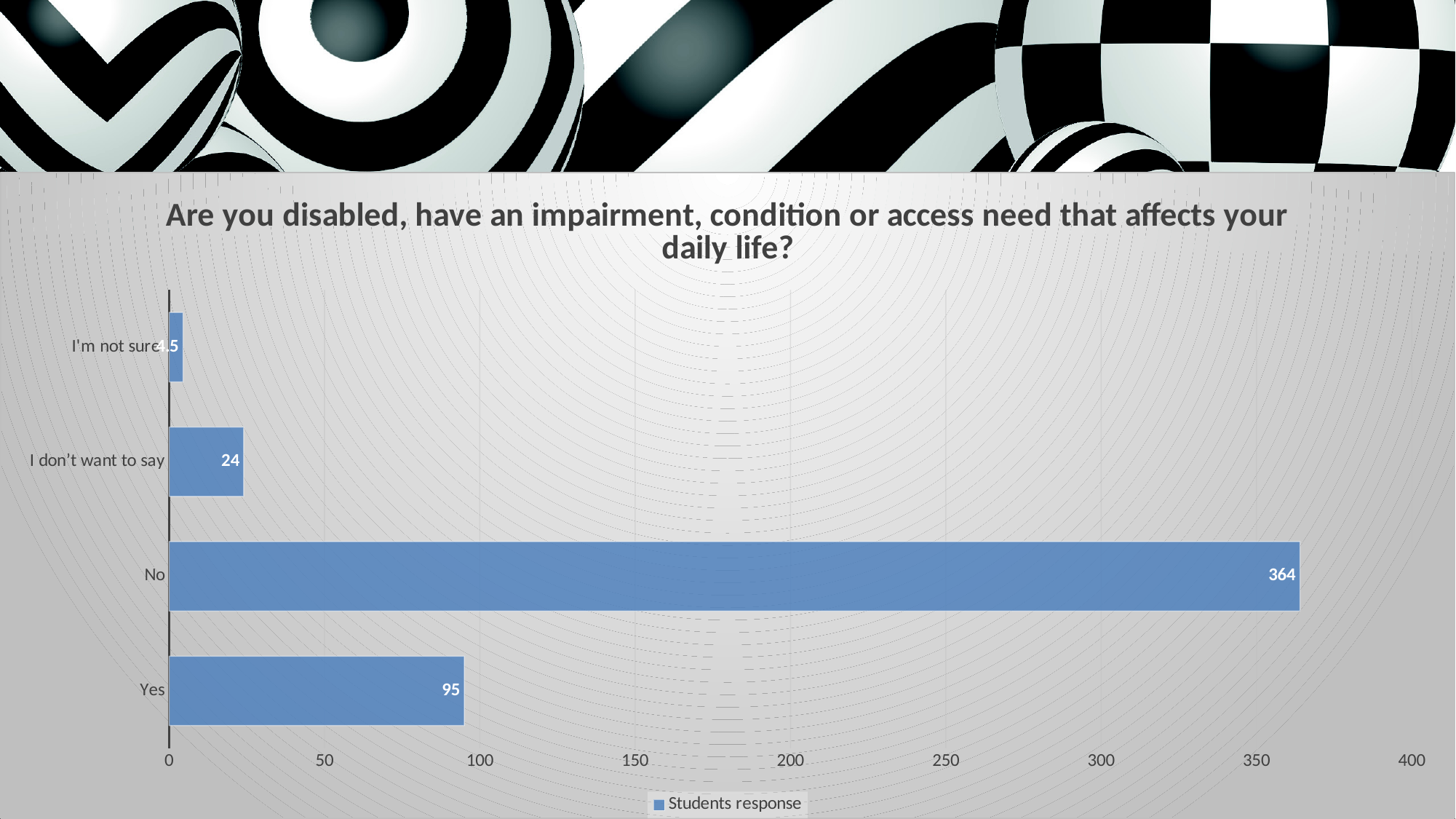
Which is larger, the value for "Yes" or the value for "I don't want to say"? Yes What is the difference between the values for "No" and "Yes"? 269 What is the difference between the values for "Yes" and "I don't want to say"? 71 How many categories are shown in the chart? 4 What is the value for "No"? 364 What series name does the legend show? Students response What is the value for "I don't want to say"? 24 Which category has the lowest value? I'm not sure What kind of chart is shown on the slide? bar chart Is the value for "I'm not sure" greater or less than 50? less Which category has the highest value? No What is the value for "Yes"? 95